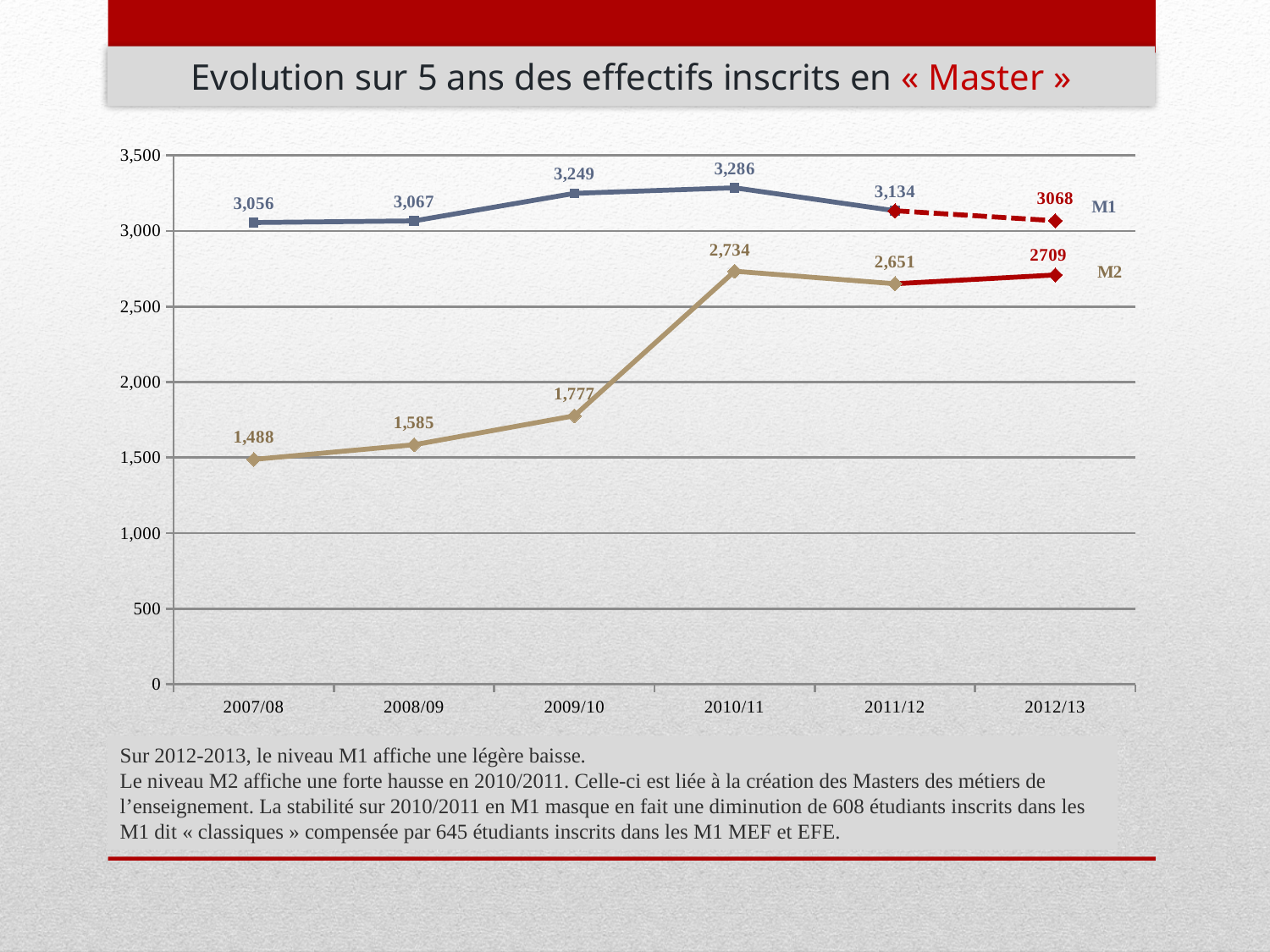
What is the M2 value for 2007/08? 1,488 In which year is the M2 value lowest? 2007/08 What is the difference between the M2 values for 2010/11 and 2009/10? 957 What is the M1 value for 2011/12? 3,134 Which is larger, the M1 value for 2008/09 or the M1 value for 2009/10? 2009/10 What kind of chart is shown on the slide? line chart Does the M2 series rise or fall from 2007/08 to 2010/11? rise How many years are shown on the x axis? 6 How many series are plotted on the chart? 2 What is the M2 value for 2012/13? 2709 What is the M1 value for 2009/10? 3,249 In which year is the M1 value highest? 2010/11